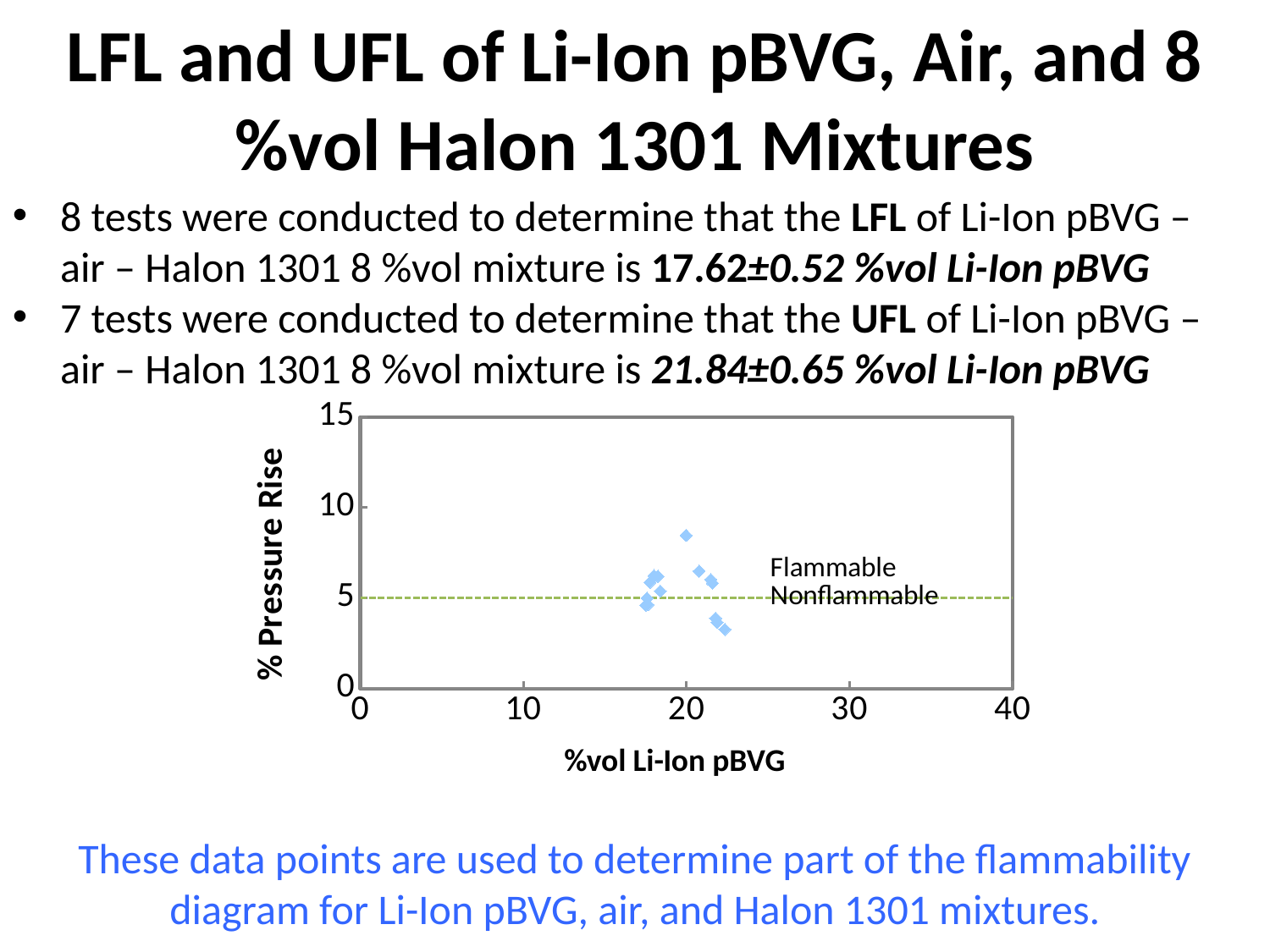
Are the plotted points located at %vol Li-Ion pBVG values greater or less than 10? greater What is the title of the y axis of the chart? % Pressure Rise What is the highest value shown on the y axis of the chart? 15 Are the plotted points located at %vol Li-Ion pBVG values greater or less than 30? less Is the % Pressure Rise of the lowest plotted point greater or less than 5? less What is the highest value shown on the x axis of the chart? 40 At what % Pressure Rise value is the dashed Flammable/Nonflammable line drawn? 5 What kind of chart is shown on the slide? scatter chart What is the title of the x axis of the chart? %vol Li-Ion pBVG